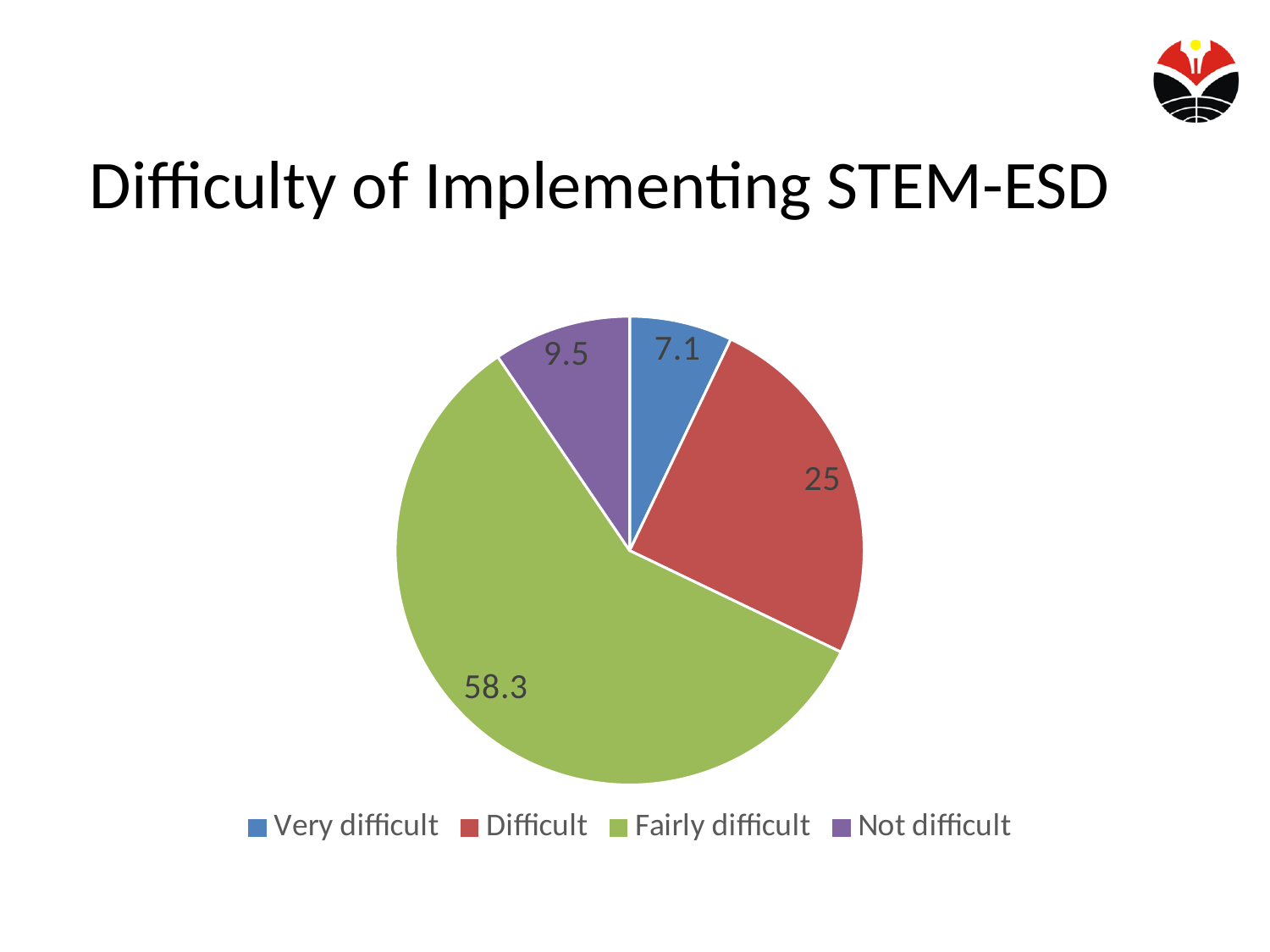
What is the value for Not difficult? 9.5 What colour is the Difficult slice? red What is the difference between the values for Fairly difficult and Difficult? 33.3 What is the title of the slide? Difficulty of Implementing STEM-ESD Which is larger, the value for Not difficult or the value for Very difficult? Not difficult What kind of chart is shown on the slide? pie chart What is the value for Fairly difficult? 58.3 Which category has the smallest slice? Very difficult What is the value for Very difficult? 7.1 What is the value for Difficult? 25 How many categories does the pie chart have? 4 Which category has the largest slice? Fairly difficult